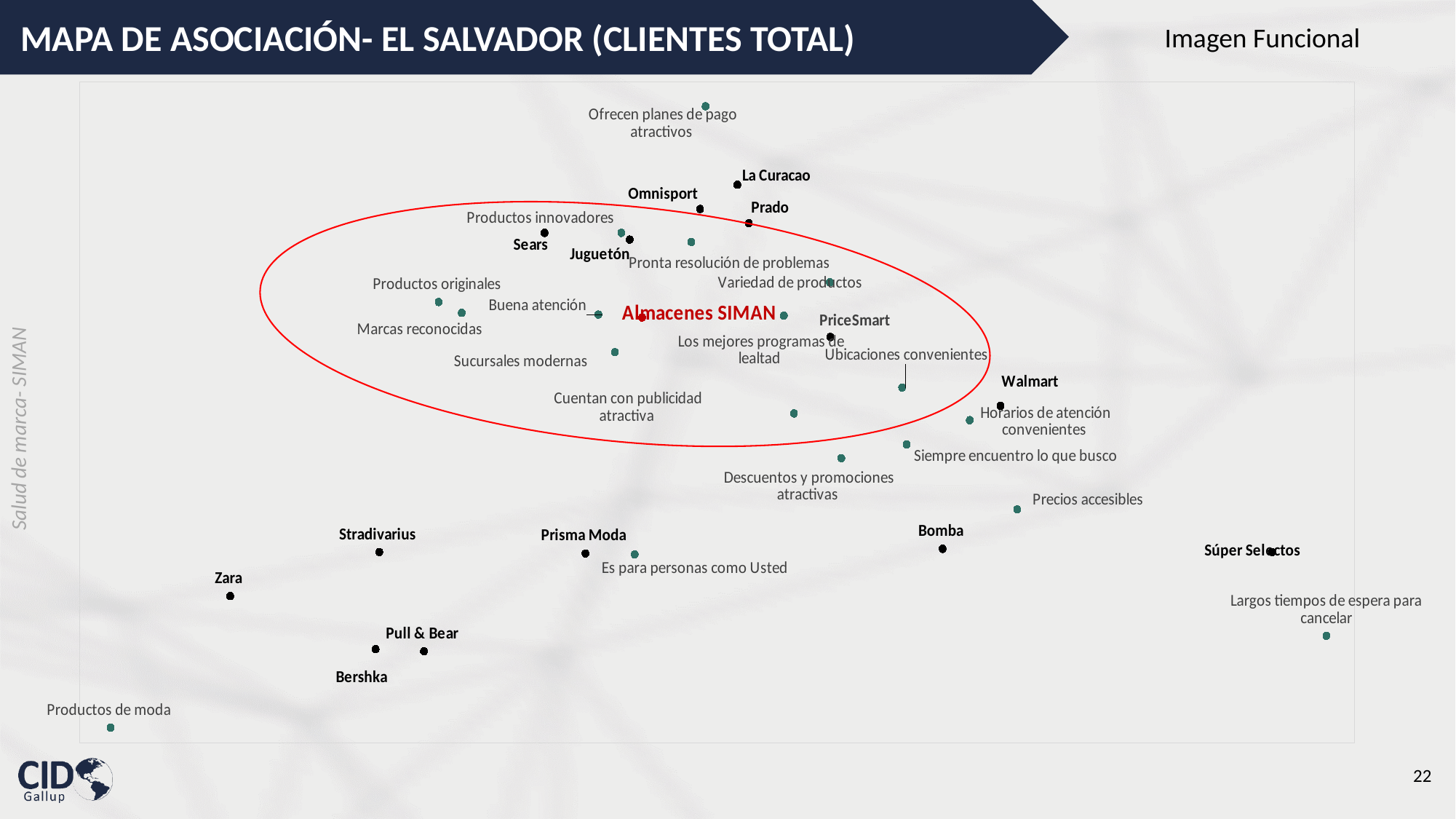
How many brands (black points) are plotted on the association map? 15 How many attributes (green points) are plotted on the association map? 18 Which attribute is plotted closest to Prisma Moda on the map? Es para personas como Usted What kind of chart is shown on the slide? Scatter plot (association/perceptual map) What is the title of the chart on the slide? MAPA DE ASOCIACIÓN- EL SALVADOR (CLIENTES TOTAL) Which brand is plotted furthest to the right on the map? Súper Selectos Which attribute is plotted furthest to the right on the map? Largos tiempos de espera para cancelar Which brand is highlighted in red on the association map? Almacenes SIMAN Which brand is plotted furthest to the left on the map? Zara Which brand is plotted highest (topmost) on the map? La Curacao Which attribute is plotted lowest (bottommost) on the map? Productos de moda